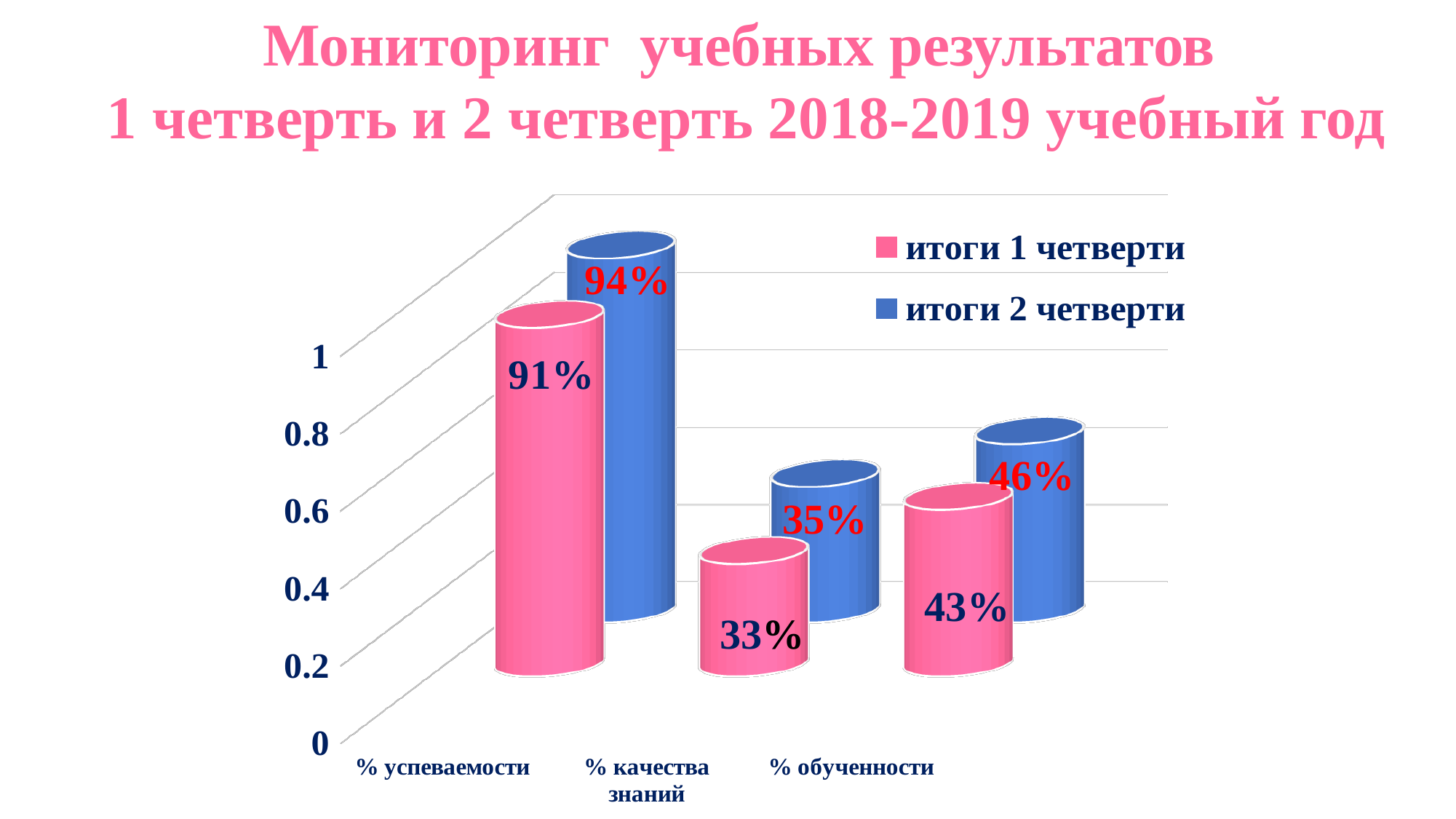
Which is larger for % качества знаний: the итоги 1 четверти value or the итоги 2 четверти value? итоги 2 четверти What is the value for % качества знаний in the итоги 1 четверти series? 33% Which category has the lowest value in the итоги 2 четверти series? % качества знаний What is the value for % успеваемости in the итоги 2 четверти series? 94% What is the difference between the итоги 2 четверти and итоги 1 четверти values for % успеваемости? 3% What is the value for % обученности in the итоги 2 четверти series? 46% What is the difference between the итоги 2 четверти and итоги 1 четверти values for % обученности? 3% How many categories are shown on the x axis? 3 What kind of chart is shown on the slide? bar chart Which category has the highest value in the итоги 1 четверти series? % успеваемости What is the value for % успеваемости in the итоги 1 четверти series? 91% How many series does the legend list? 2